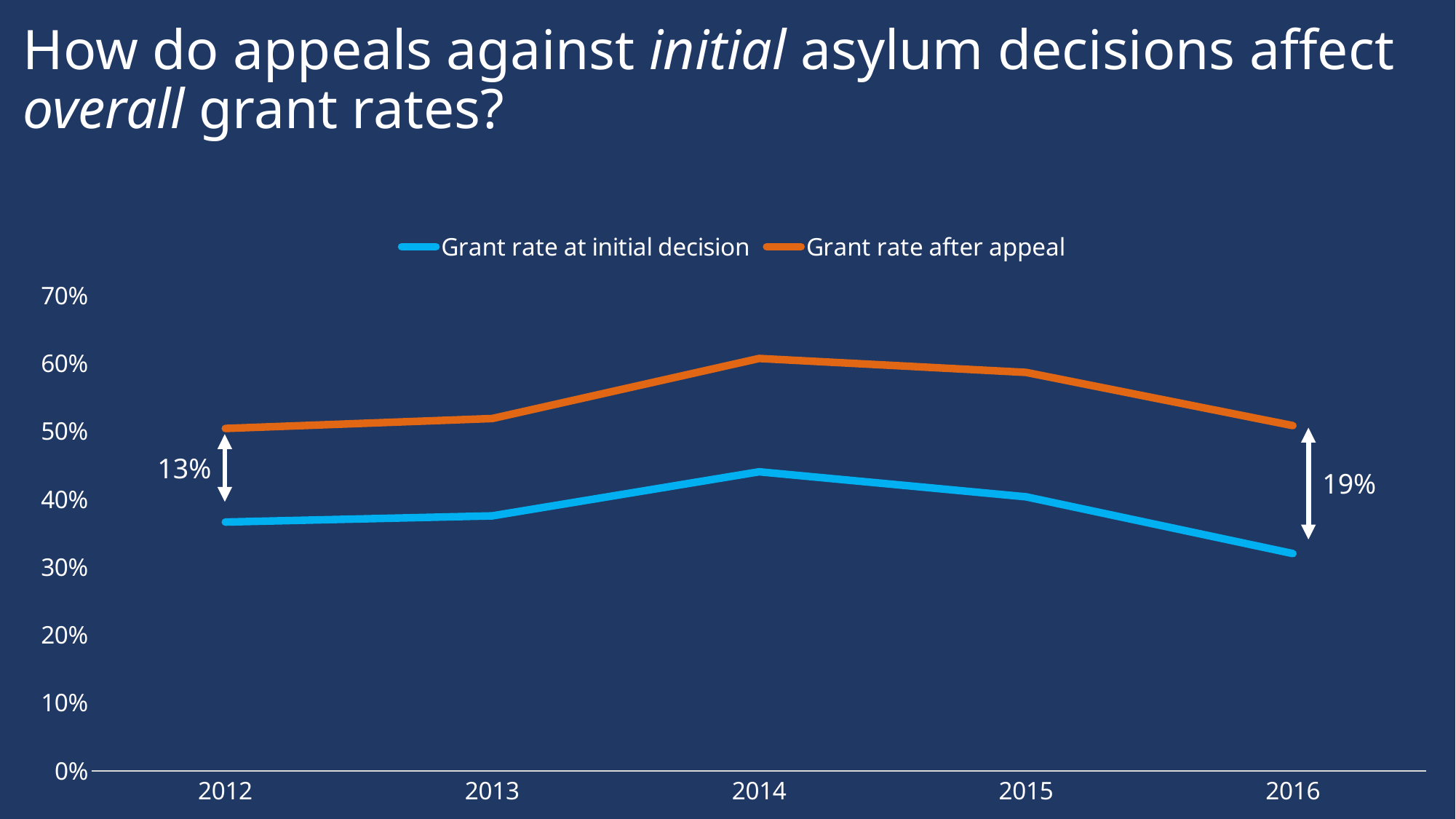
Is the grant rate after appeal in 2014 greater or less than 50%? greater What kind of chart is shown on the slide? line chart How many series does the legend list? 2 Is the grant rate at initial decision in 2012 greater or less than 40%? less In which year is the grant rate after appeal highest? 2014 Which is larger in 2015, the grant rate after appeal or the grant rate at initial decision? Grant rate after appeal How many years are plotted along the x axis? 5 Does the grant rate at initial decision rise or fall from 2014 to 2016? fall In which year is the grant rate at initial decision lowest? 2016 Which series is drawn in orange? Grant rate after appeal According to the label on the chart, what is the gap between the grant rate after appeal and the grant rate at initial decision in 2016? 19% According to the label on the chart, what is the gap between the grant rate after appeal and the grant rate at initial decision in 2012? 13%